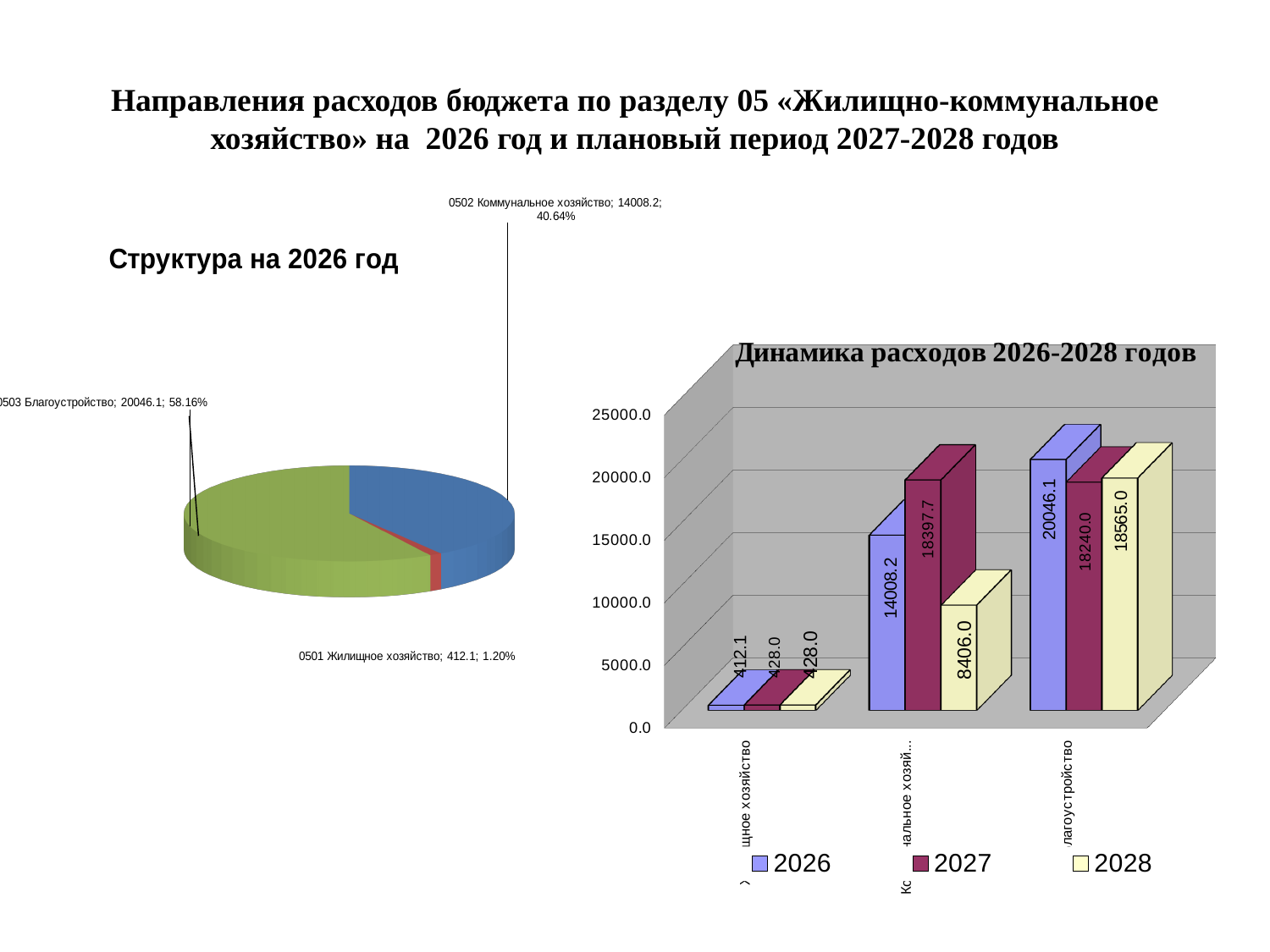
In the chart 'Динамика расходов 2026-2028 годов', what is the value for Благоустройство in 2028? 18565.0 In the chart 'Динамика расходов 2026-2028 годов', which is larger: Благоустройство in 2027 or Благоустройство in 2028? Благоустройство in 2028 In the pie chart 'Структура на 2026 год', which category has the smallest slice? 0501 Жилищное хозяйство In the chart 'Динамика расходов 2026-2028 годов', how many series does the legend list? 3 In the chart 'Динамика расходов 2026-2028 годов', what is the value for Коммунальное хозяйство in 2027? 18397.7 In the chart 'Динамика расходов 2026-2028 годов', what colour represents the 2027 series? Dark red In the pie chart 'Структура на 2026 год', what is the value for 0502 Коммунальное хозяйство? 14008.2 How many slices does the pie chart 'Структура на 2026 год' have? 3 In the chart 'Динамика расходов 2026-2028 годов', what is the difference between the 2027 and 2028 values for Коммунальное хозяйство? 9991.7 In the pie chart 'Структура на 2026 год', what share does 0503 Благоустройство have? 58.16% In the chart 'Динамика расходов 2026-2028 годов', which year has the highest value for Благоустройство? 2026 What type of chart is 'Динамика расходов 2026-2028 годов'? Bar chart